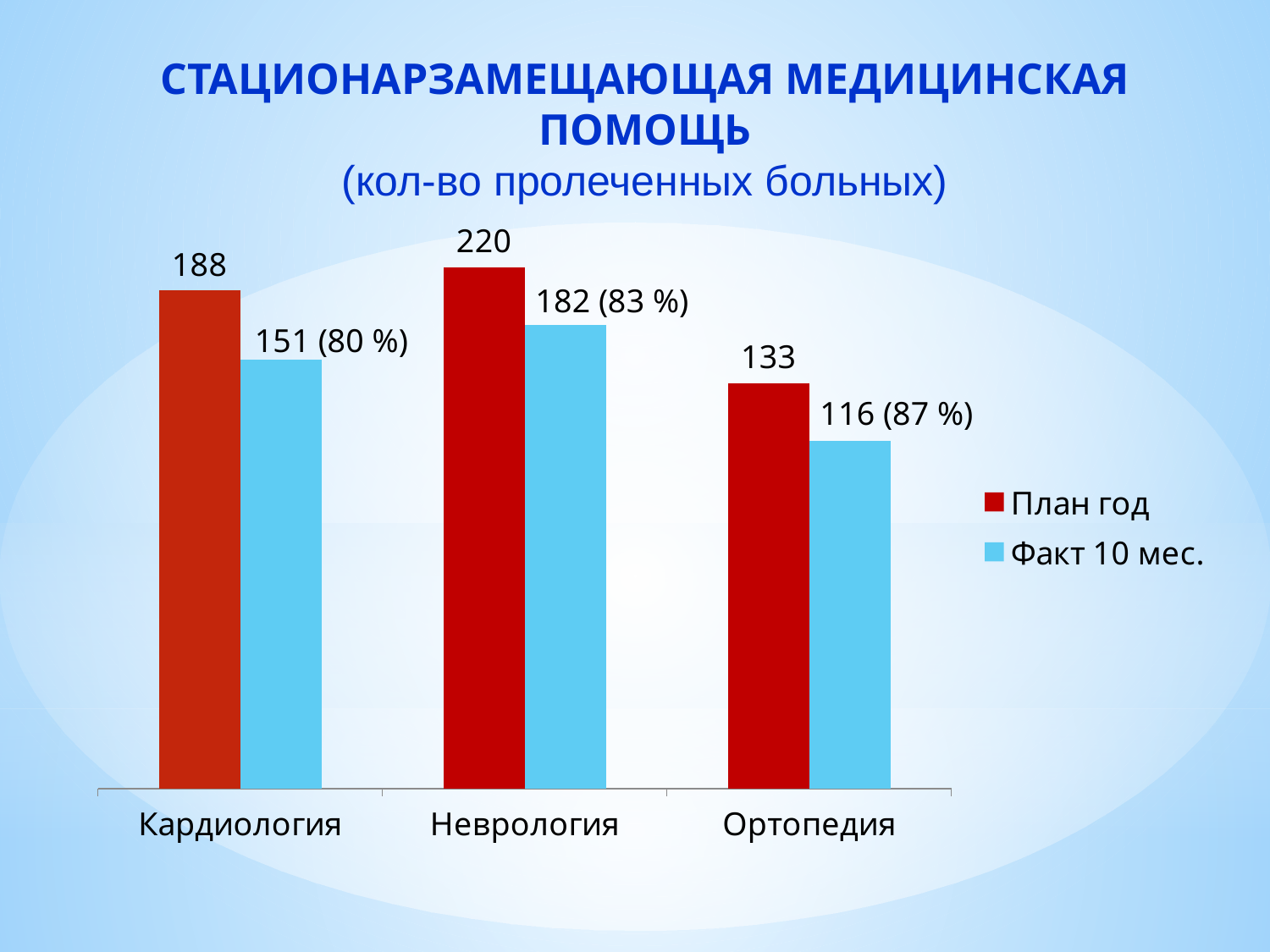
How many categories are shown on the x axis? 3 What kind of chart is shown on the slide? Bar chart What is the data label shown for Факт 10 мес. for Ортопедия? 116 (87 %) Which series is shown in red in the legend? План год How many series does the legend list? 2 What is the data label shown for Факт 10 мес. for Неврология? 182 (83 %) What is the value of План год for Кардиология? 188 What is the difference between План год and Факт 10 мес. for Кардиология? 37 Which is larger: Факт 10 мес. for Кардиология or Факт 10 мес. for Неврология? Неврология Which category has the highest План год value? Неврология Which category has the lowest Факт 10 мес. value? Ортопедия What is the value of План год for Ортопедия? 133